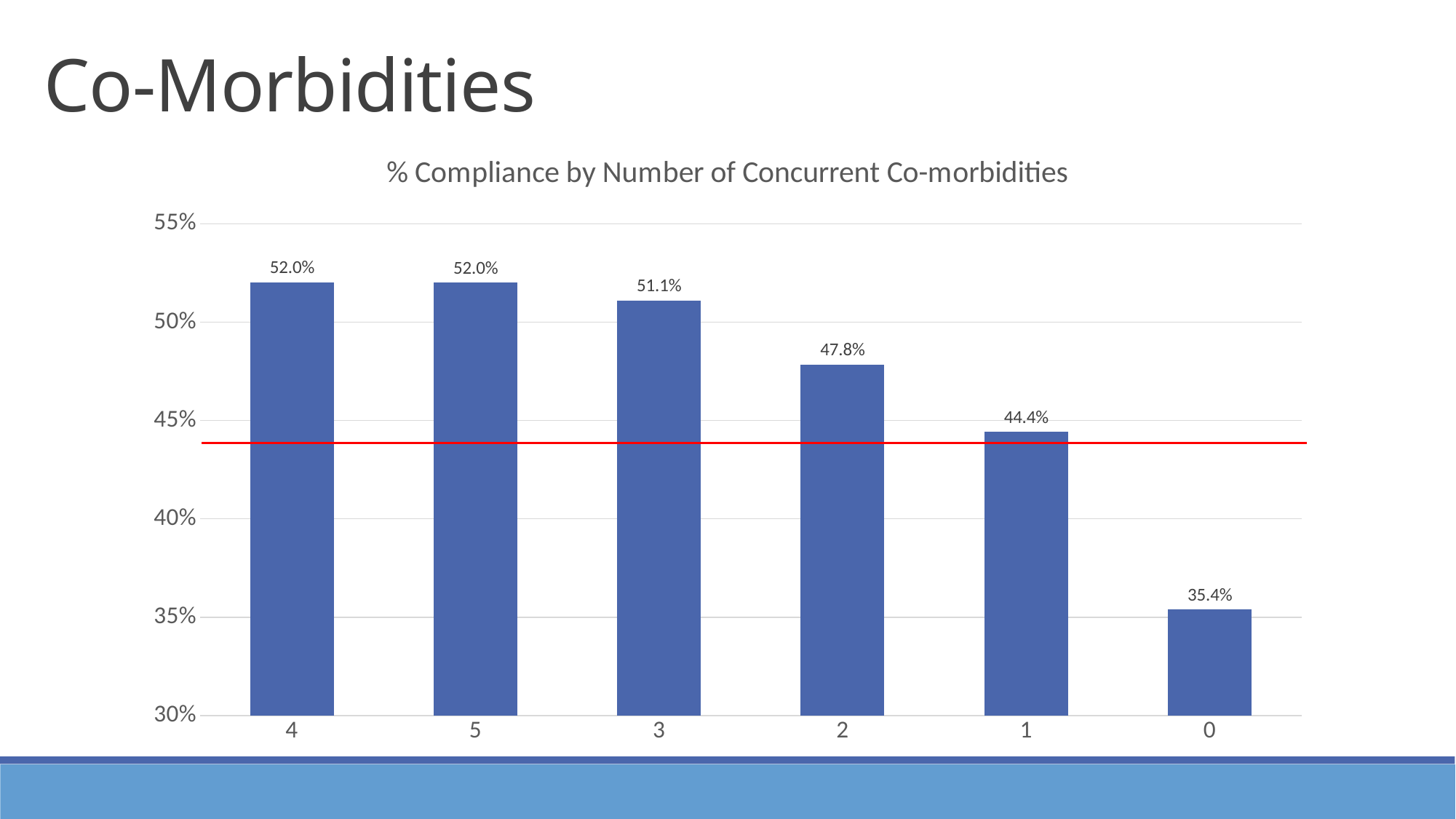
Which number of co-morbidities has the lowest % compliance? 0 What is the title of the chart? % Compliance by Number of Concurrent Co-morbidities What is the % compliance for 3 concurrent co-morbidities? 51.1% What is the % compliance for 1 concurrent co-morbidity? 44.4% What is the difference in % compliance between 3 and 0 co-morbidities? 15.7% How many bars are shown in the chart? 6 Which has a higher % compliance, 2 co-morbidities or 1 co-morbidity? 2 What is the % compliance for 0 concurrent co-morbidities? 35.4% Is the value for 0 co-morbidities greater or less than 40%? less What kind of chart is shown on the slide? Bar chart What is the difference in % compliance between 4 and 2 co-morbidities? 4.2% What is the % compliance for 2 concurrent co-morbidities? 47.8%